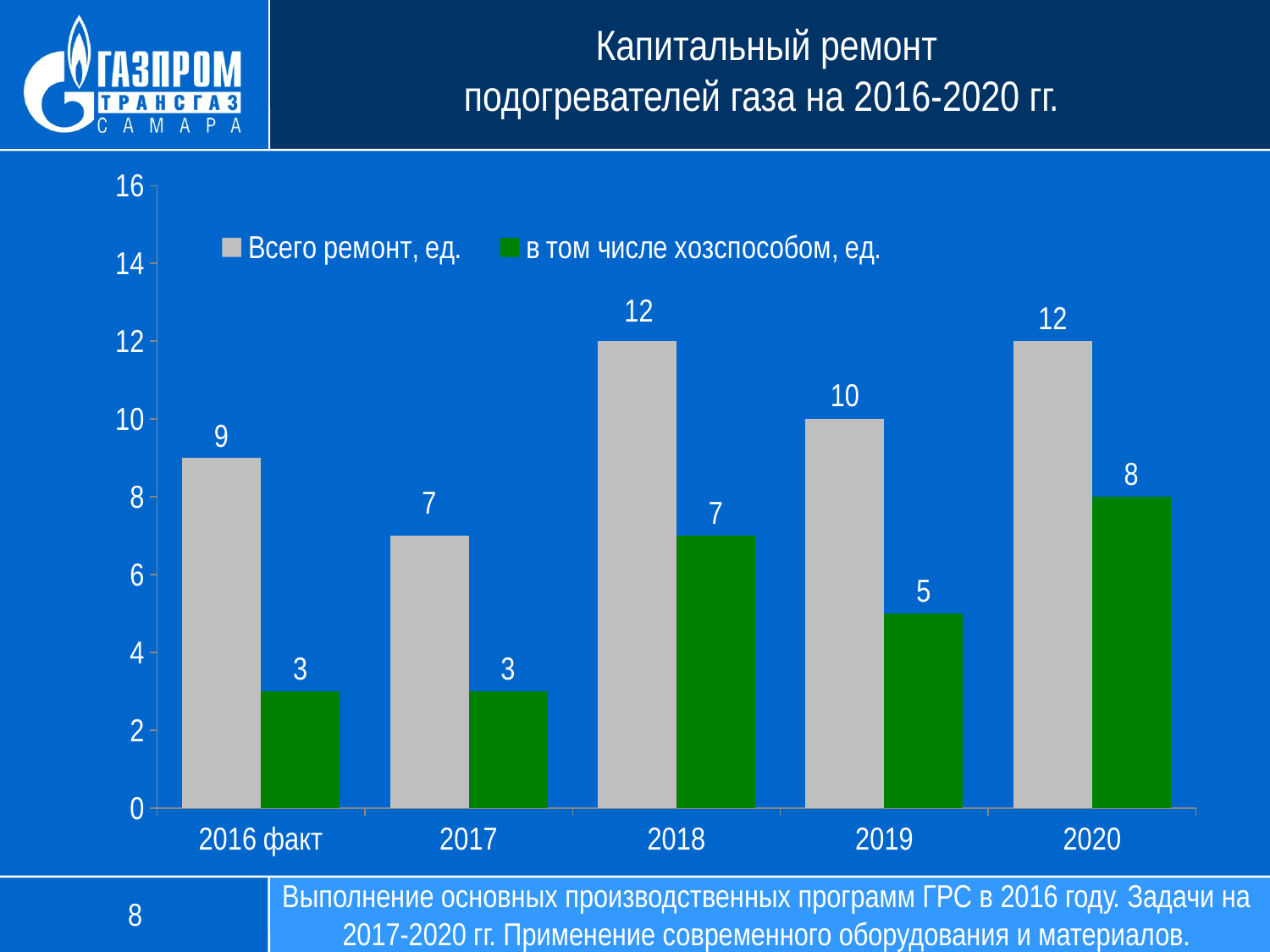
What is the value of "Всего ремонт, ед." for 2018? 12 Which is larger: "в том числе хозспособом, ед." for 2018 or for 2019? 2018 What is the difference between "Всего ремонт, ед." and "в том числе хозспособом, ед." for 2020? 4 Which category has the lowest value for "Всего ремонт, ед."? 2017 What is the value of "Всего ремонт, ед." for 2016 факт? 9 Is the value of "Всего ремонт, ед." for 2019 greater or less than 8? greater How many series does the legend list? 2 How many categories are shown on the x axis? 5 What is the value of "в том числе хозспособом, ед." for 2019? 5 What colour are the bars for "в том числе хозспособом, ед."? green Which category has the highest value for "в том числе хозспособом, ед."? 2020 What kind of chart is shown on the slide? bar chart